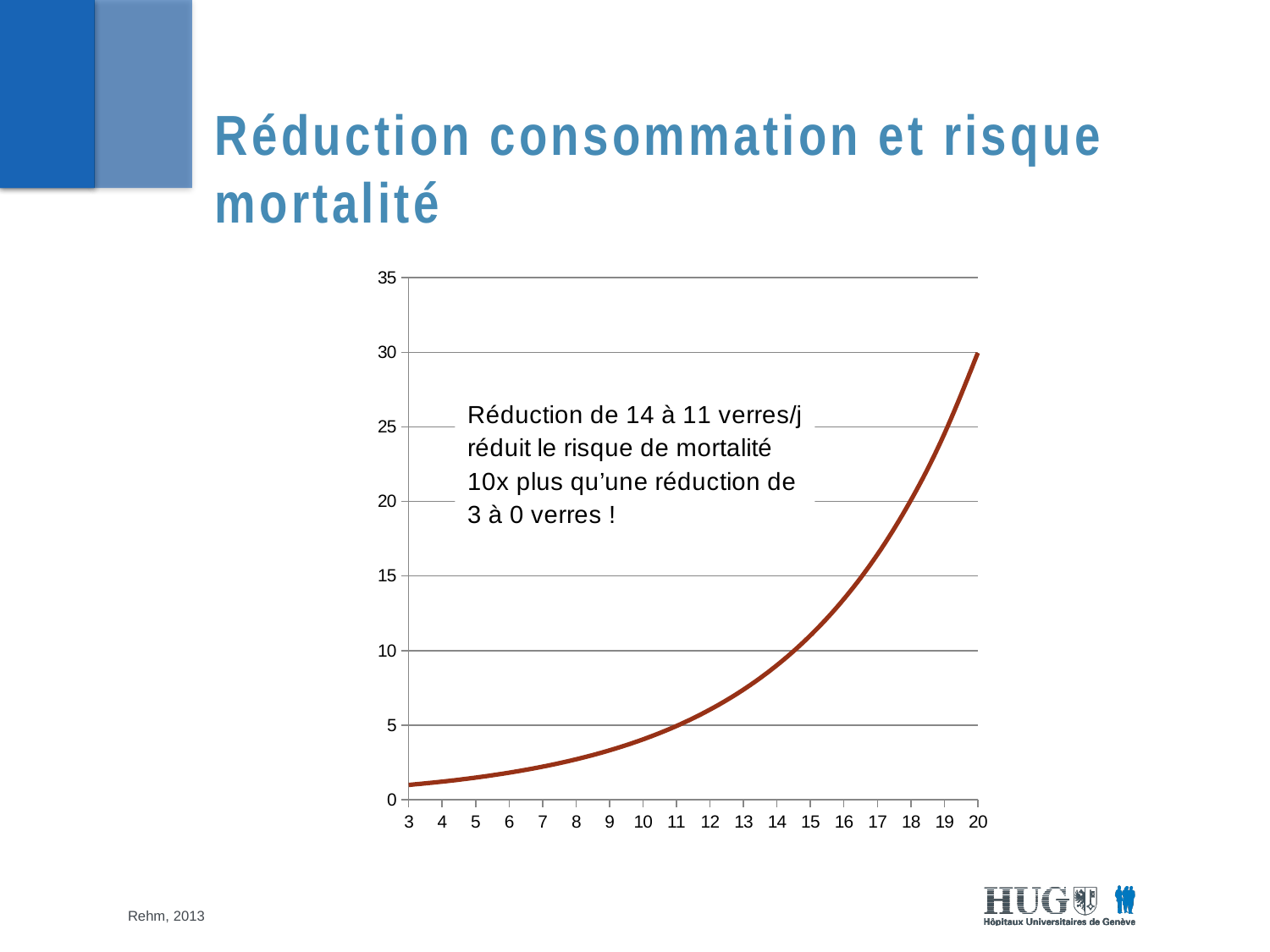
How many tick labels are shown on the x axis of the chart? 18 At which x-axis value does the curve reach its highest point? 20 Is the value of the curve at x = 3 greater or less than 5? less Do the values on the chart rise or fall as the x axis goes from 3 to 20? rise Is the value of the curve at x = 20 greater or less than 25? greater Is the value of the curve at x = 10 greater or less than 5? less Which is larger, the value of the curve at x = 20 or at x = 3? x = 20 What is the title of the slide containing the chart? Réduction consommation et risque mortalité What is the highest value labelled on the y axis of the chart? 35 At which x-axis value does the curve have its lowest point? 3 What kind of chart is shown on the slide? line chart